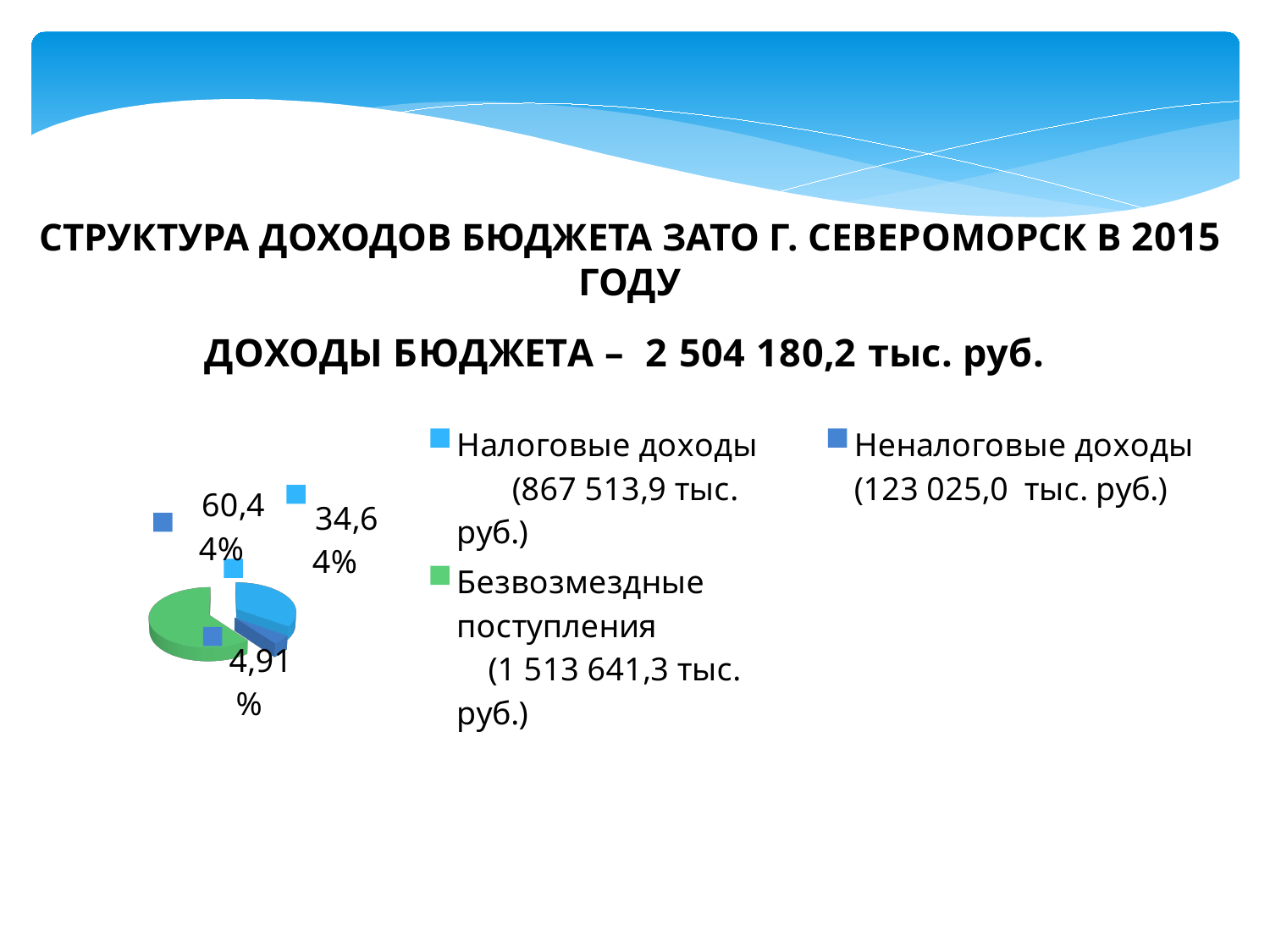
What share of the pie does Налоговые доходы have? 34,64% What colour is the slice for Безвозмездные поступления? green What amount in тыс. руб. does the legend give for Неналоговые доходы? 123 025,0 тыс. руб. Which category has the smallest slice of the pie? Неналоговые доходы Which is larger, the share of Налоговые доходы or the share of Неналоговые доходы? Налоговые доходы How many slices does the pie chart have? 3 What share of the pie does Неналоговые доходы have? 4,91% What share of the pie does Безвозмездные поступления have? 60,44% What kind of chart is shown on the slide? pie chart What amount in тыс. руб. does the legend give for Налоговые доходы? 867 513,9 тыс. руб. Which category has the largest slice of the pie? Безвозмездные поступления How many entries does the legend of the pie chart list? 3